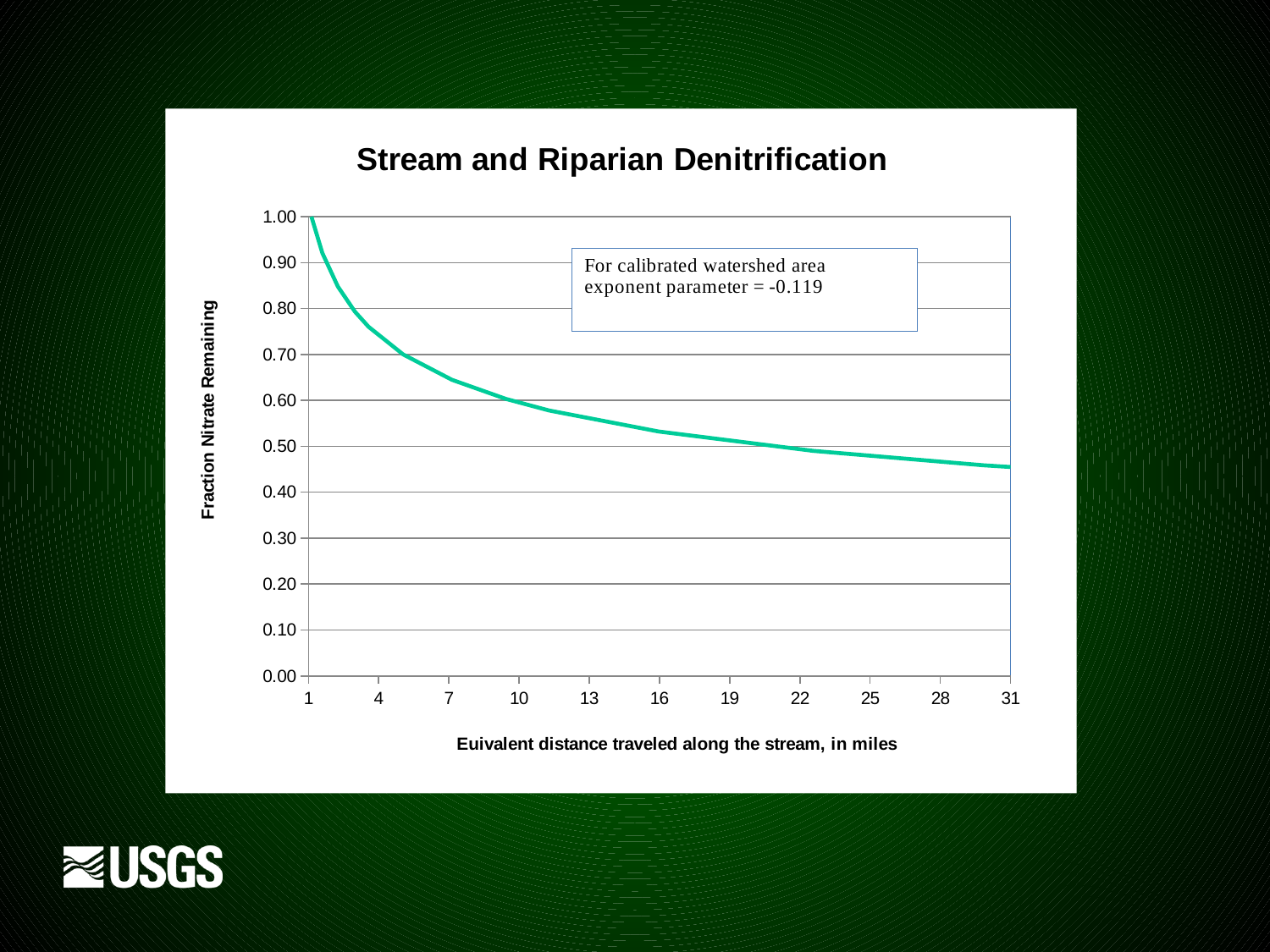
Is the fraction of nitrate remaining at 4 miles greater or less than 0.70? greater What is the fraction of nitrate remaining at a distance of 1 mile? 1.00 What type of chart is shown on the slide? line chart Is the fraction of nitrate remaining at 31 miles greater or less than 0.50? less What is the label of the y axis? Fraction Nitrate Remaining Is the fraction of nitrate remaining at 13 miles greater or less than 0.60? less What is the title of the chart? Stream and Riparian Denitrification At which distance on the x axis is the fraction of nitrate remaining highest? 1 Does the fraction of nitrate remaining rise or fall as the distance traveled along the stream increases? fall At which distance on the x axis is the fraction of nitrate remaining lowest? 31